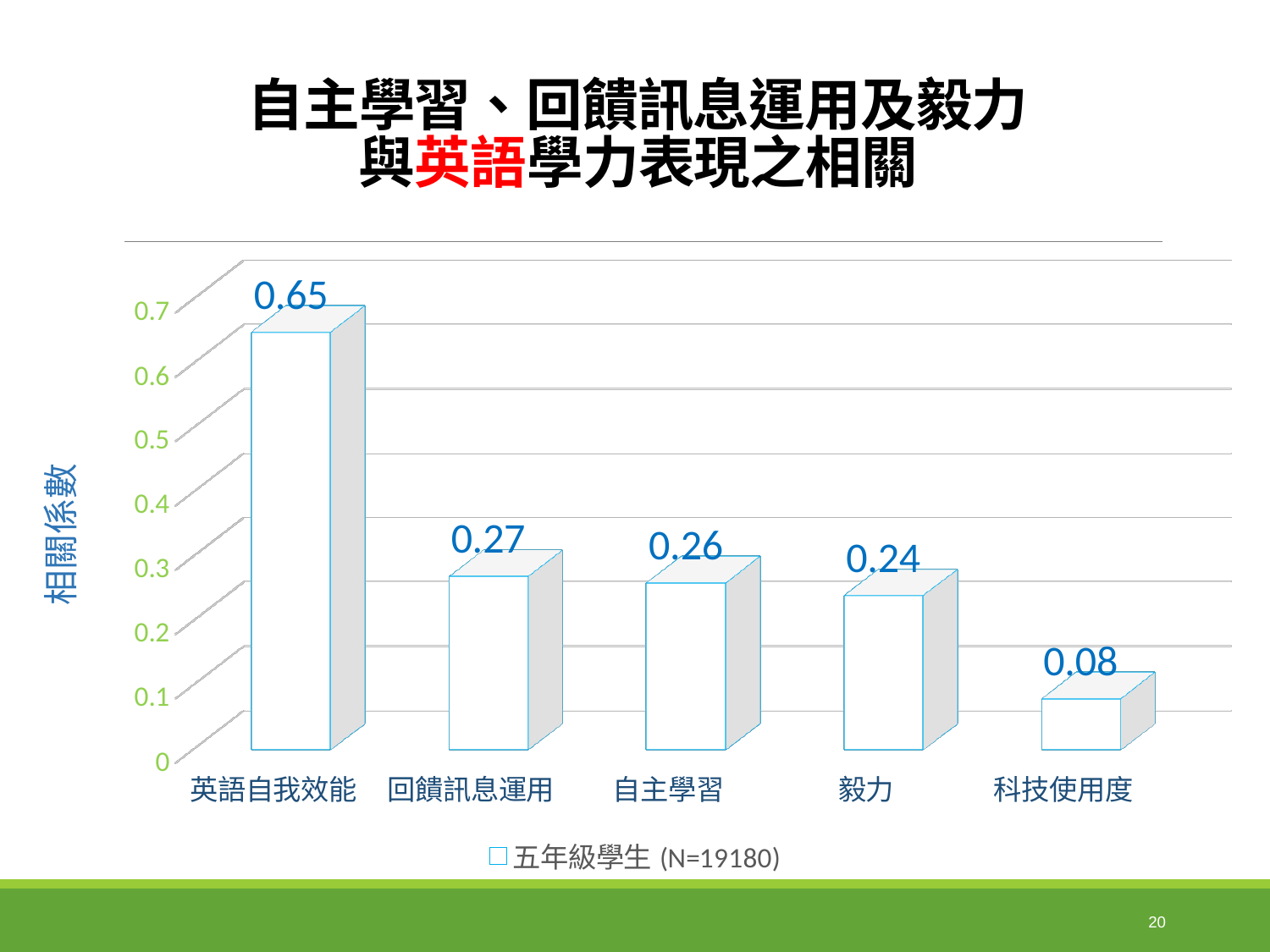
What is the difference between the values for 毅力 and 科技使用度? 0.16 What series does the legend list? 五年級學生 (N=19180) What kind of chart is shown on the slide? bar chart Is the value for 自主學習 greater or less than 0.3? less Which is larger, the value for 回饋訊息運用 or the value for 毅力? 回饋訊息運用 Which category has the lowest correlation coefficient? 科技使用度 What is the difference between the values for 英語自我效能 and 回饋訊息運用? 0.38 What is the correlation coefficient for 英語自我效能? 0.65 How many categories are shown on the x axis? 5 Which category has the highest correlation coefficient? 英語自我效能 What is the value shown for 毅力? 0.24 What is the value shown for 科技使用度? 0.08